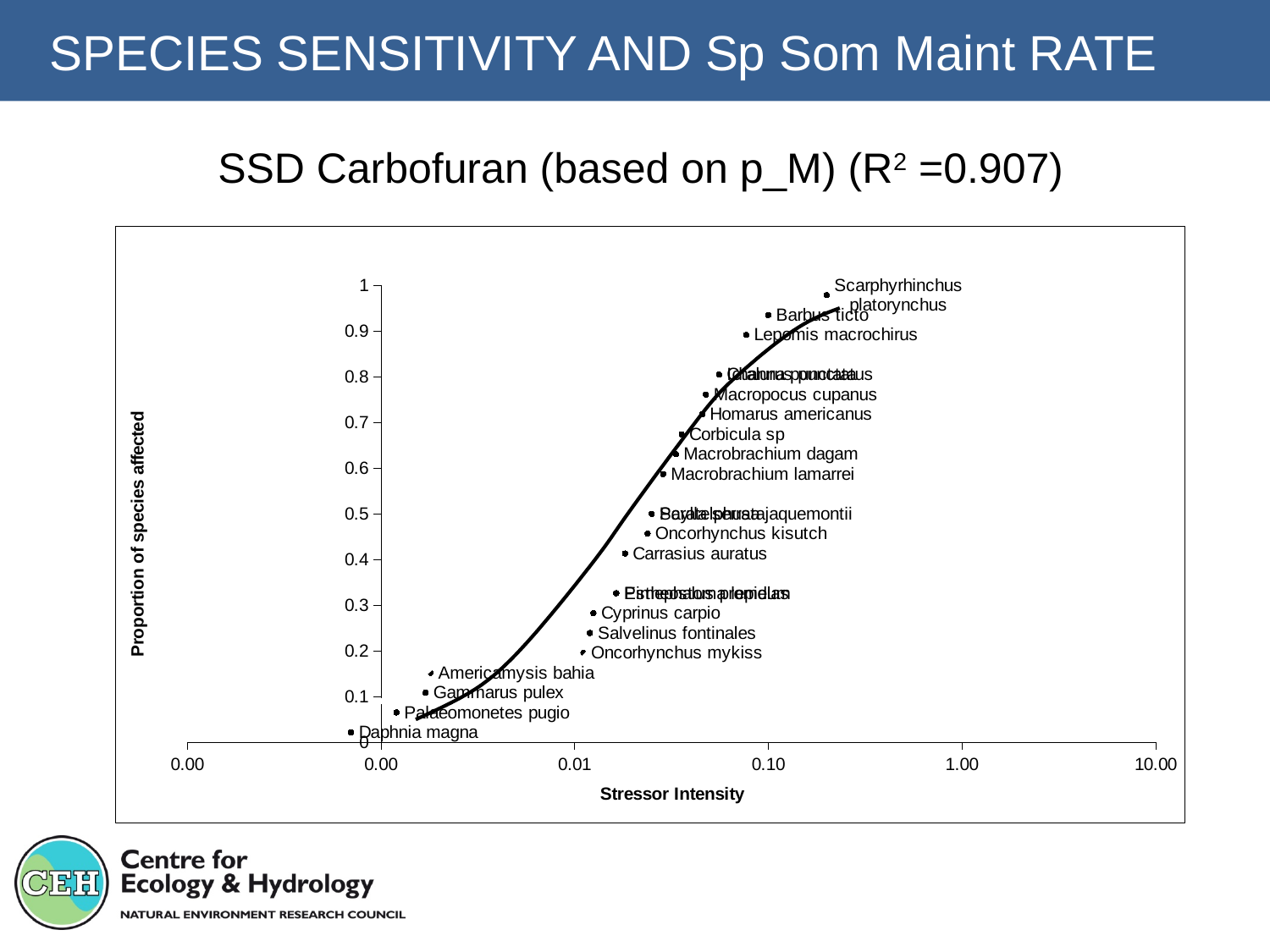
Is the value for Americamysis bahia greater or less than 0.2? less Is the value for Scarphyrhinchus platorynchus greater or less than 0.9? greater Which species has the lowest proportion of species affected? Daphnia magna What is the label of the y axis? Proportion of species affected Is the value for Daphnia magna greater or less than 0.1? less Which has a higher proportion of species affected, Barbus ticto or Palaeomonetes pugio? Barbus ticto What is the title of the chart? SSD Carbofuran (based on p_M) (R² =0.907) What kind of chart is shown on the slide? Scatter chart Which species has the highest proportion of species affected? Scarphyrhinchus platorynchus Do the plotted values rise or fall as stressor intensity increases along the x axis? Rise